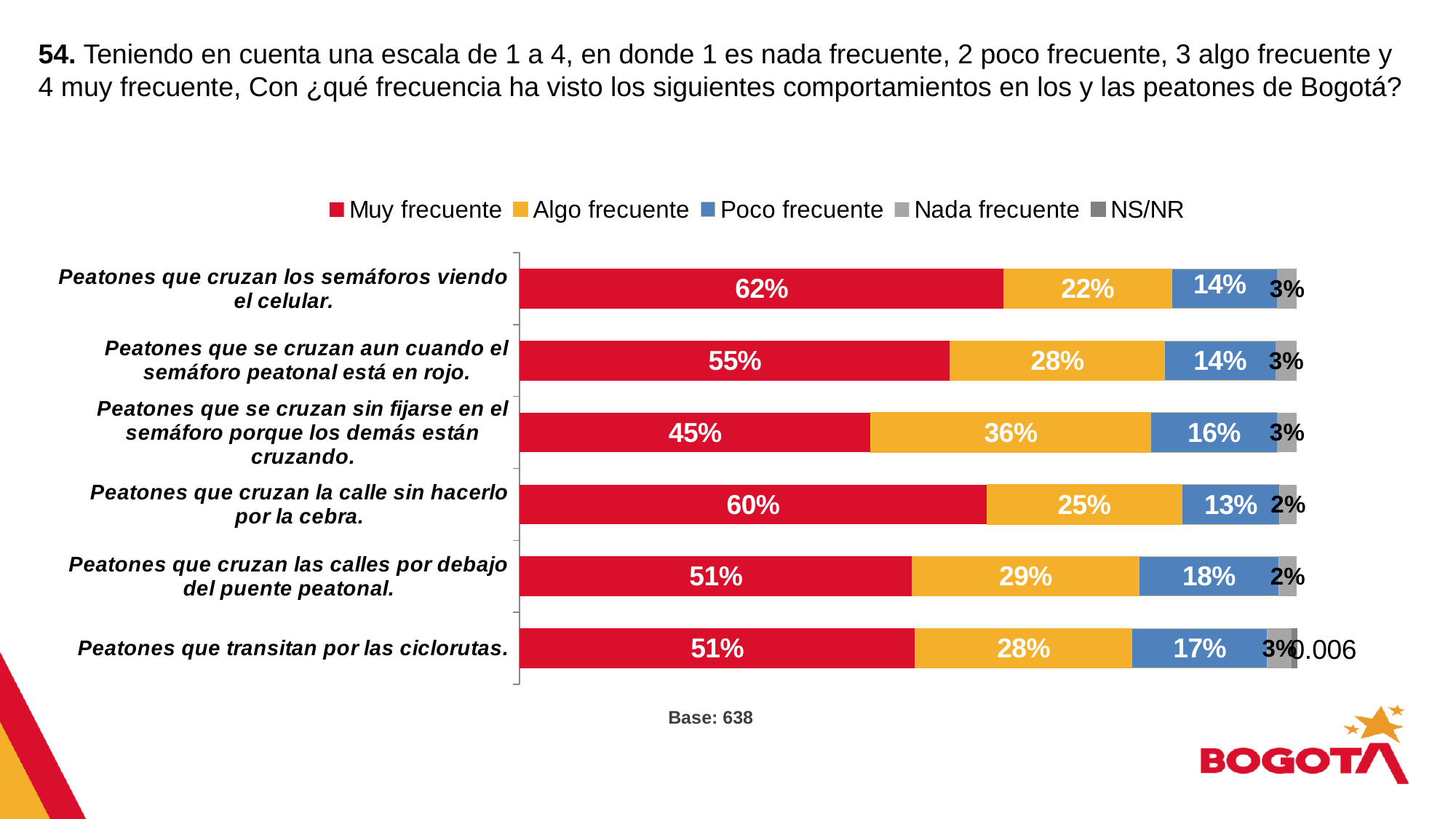
What kind of chart is shown on the slide? Stacked bar chart What is the 'Algo frecuente' value for 'Peatones que se cruzan sin fijarse en el semáforo porque los demás están cruzando'? 36% What is the difference in 'Muy frecuente' percentage between 'Peatones que cruzan los semáforos viendo el celular' and 'Peatones que se cruzan aun cuando el semáforo peatonal está en rojo'? 7 percentage points Which behaviour has the highest 'Muy frecuente' percentage? Peatones que cruzan los semáforos viendo el celular What percentage of respondents said 'Muy frecuente' for 'Peatones que cruzan los semáforos viendo el celular'? 62% What is the base (number of respondents) shown below the chart? 638 How many pedestrian behaviours are shown in the chart? 6 How many series does the legend list? 5 What is the 'Poco frecuente' value for 'Peatones que cruzan las calles por debajo del puente peatonal'? 18% Which behaviour has the highest 'Algo frecuente' percentage? Peatones que se cruzan sin fijarse en el semáforo porque los demás están cruzando Which has a larger 'Poco frecuente' value: 'Peatones que cruzan la calle sin hacerlo por la cebra' or 'Peatones que transitan por las ciclorutas'? Peatones que transitan por las ciclorutas Which behaviour has the lowest 'Muy frecuente' percentage? Peatones que se cruzan sin fijarse en el semáforo porque los demás están cruzando